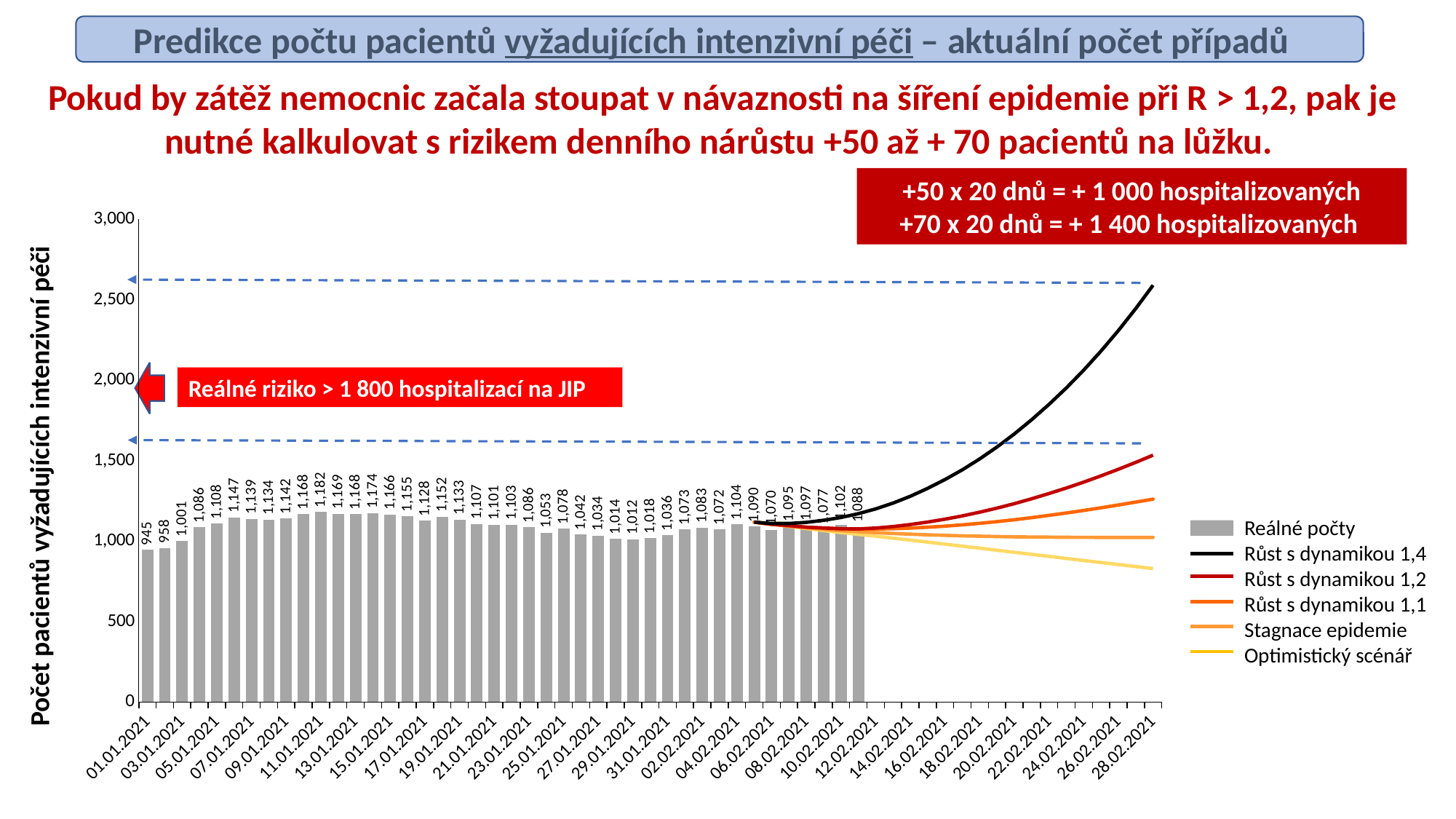
What is the difference between the highest bar value (1,182) and the lowest bar value (945)? 237 What is the title of the vertical axis? Počet pacientů vyžadujících intenzivní péči Is the value of the Růst s dynamikou 1,1 line at 28.02.2021 greater or less than 1,500? less Is the value of the Optimistický scénář line at 28.02.2021 greater or less than 1,000? less Is the value of the Růst s dynamikou 1,4 line at 28.02.2021 greater or less than 2,000? greater Which is larger: the bar for 01.01.2021 or the bar for 03.01.2021? 03.01.2021 What is the highest value among the grey bars (Reálné počty)? 1,182 What kind of chart is shown on the slide? A bar chart with line series What is the lowest value among the grey bars (Reálné počty)? 945 Does the Růst s dynamikou 1,4 line rise or fall as it moves toward 28.02.2021? Rise How many series does the chart legend list? 6 What is the value of the first bar, for 01.01.2021? 945